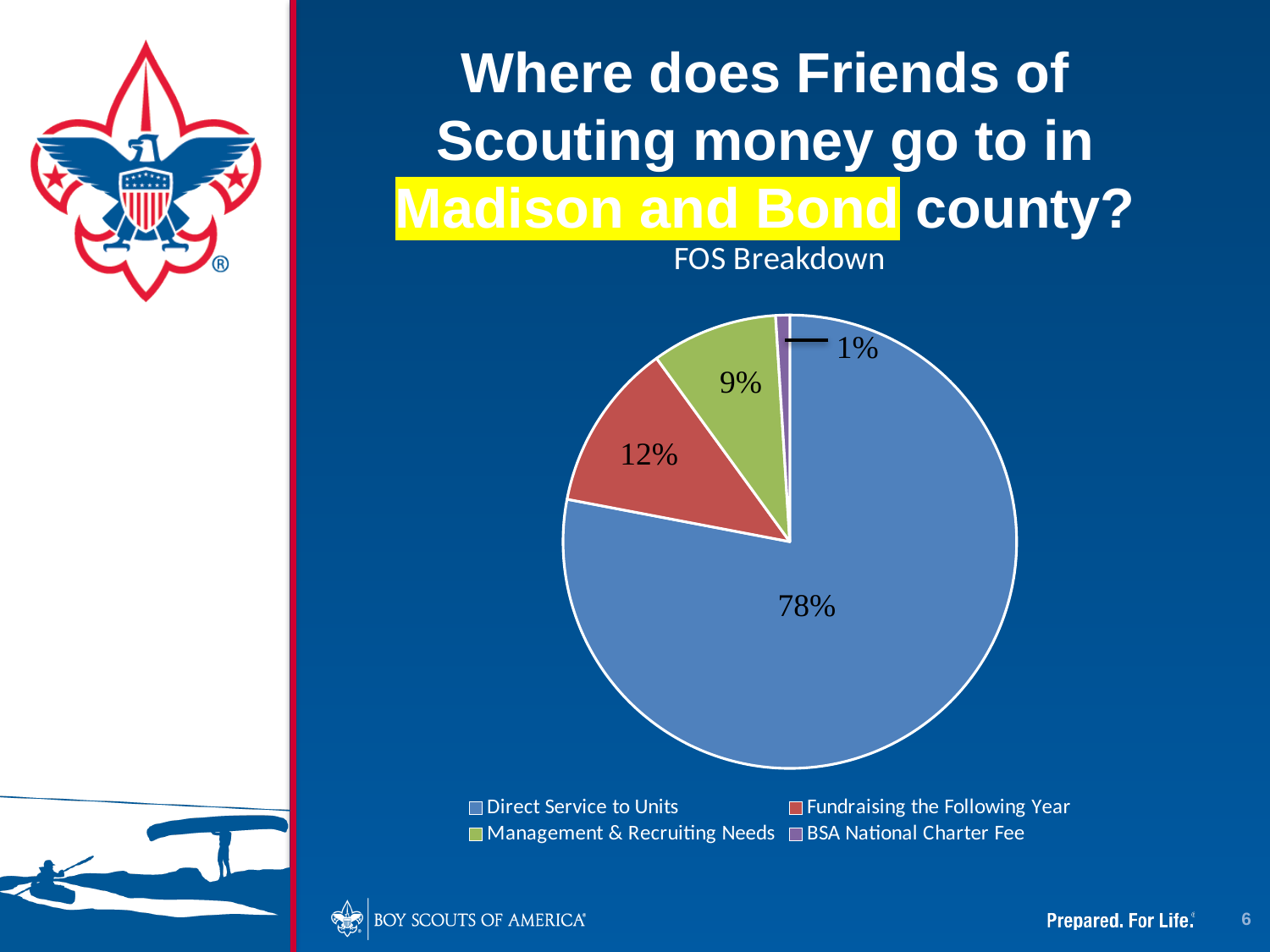
What share of the pie is Management & Recruiting Needs? 9% What is the difference between the Fundraising the Following Year share and the Management & Recruiting Needs share? 3% What share of the pie is Fundraising the Following Year? 12% How many slices does the pie chart have? 4 Which category has the largest slice of the pie? Direct Service to Units How many entries does the legend list? 4 What kind of chart is shown on the slide? pie chart Which is larger, the share for Fundraising the Following Year or the share for Management & Recruiting Needs? Fundraising the Following Year What share of the pie is Direct Service to Units? 78% Which category has the smallest slice of the pie? BSA National Charter Fee What is the title of the chart? FOS Breakdown